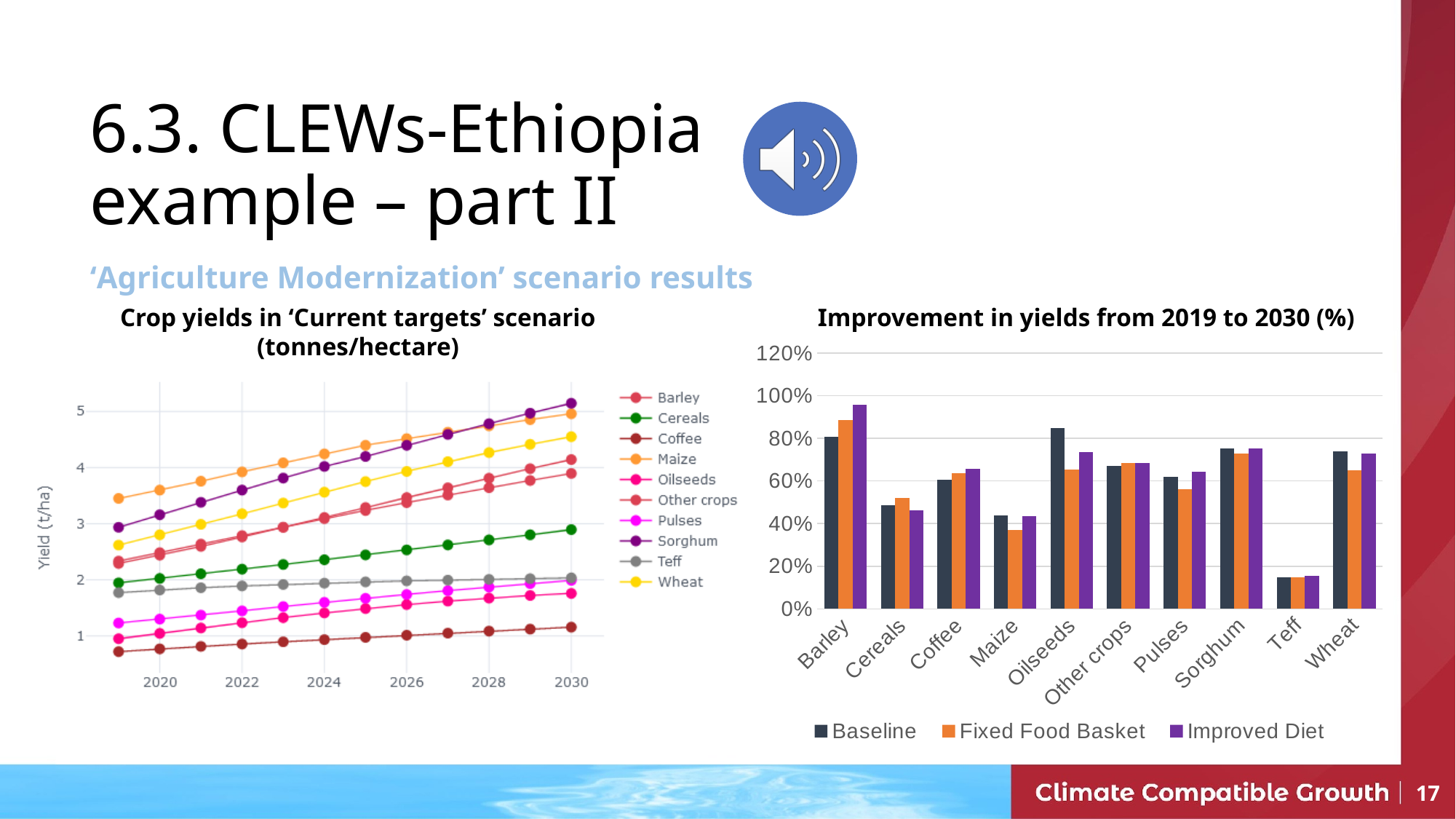
How many crop categories are shown on the x axis of the 'Improvement in yields from 2019 to 2030 (%)' chart? 10 In the 'Improvement in yields from 2019 to 2030 (%)' chart, is the Fixed Food Basket value for Maize greater or less than 40%? less How many series does the legend of the left chart, 'Crop yields in ‘Current targets’ scenario', list? 10 In the 'Improvement in yields from 2019 to 2030 (%)' chart, is the Improved Diet value for Barley greater or less than 90%? greater In the 'Crop yields in ‘Current targets’ scenario' chart, does the Sorghum yield rise or fall from 2020 to 2030? rise In the 'Crop yields in ‘Current targets’ scenario' chart, which crop has the lowest yield across the whole period? Coffee In the 'Improvement in yields from 2019 to 2030 (%)' chart, which is larger for Oilseeds: the Baseline value or the Fixed Food Basket value? Baseline How many series does the legend of the right chart, 'Improvement in yields from 2019 to 2030 (%)', list? 3 In the 'Crop yields in ‘Current targets’ scenario' chart, which crop has the highest yield in 2030? Sorghum What kind of chart is the 'Improvement in yields from 2019 to 2030 (%)' chart on the right? bar chart What kind of chart is the 'Crop yields in ‘Current targets’ scenario' chart on the left? line chart In the 'Improvement in yields from 2019 to 2030 (%)' chart, which crop has the lowest Baseline improvement? Teff